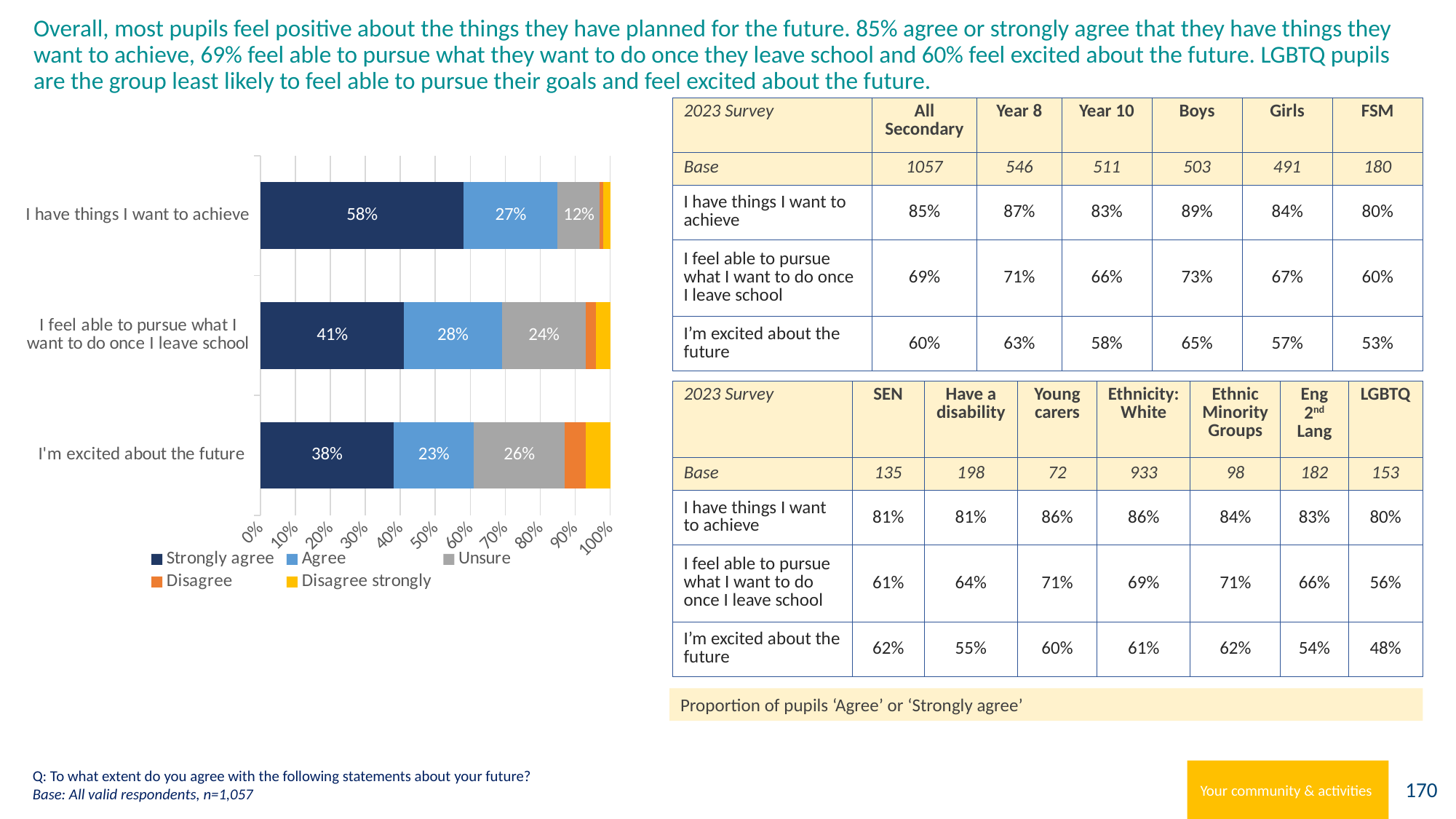
What is the difference between the 'Strongly agree' values for 'I have things I want to achieve' and 'I'm excited about the future'? 20% How many series does the chart legend list? 5 Which series in the legend is shown in grey? Unsure Which is larger: the 'Agree' value for 'I have things I want to achieve' or the 'Agree' value for 'I'm excited about the future'? I have things I want to achieve Is the 'Disagree strongly' value for 'I'm excited about the future' greater or less than 10%? less What is the 'Unsure' value for 'I'm excited about the future'? 26% Which statement has the highest 'Strongly agree' value? I have things I want to achieve What kind of chart is shown on the slide? bar chart Which statement has the lowest 'Unsure' value? I have things I want to achieve What is the 'Agree' value for 'I feel able to pursue what I want to do once I leave school'? 28% What is the 'Strongly agree' value for 'I have things I want to achieve'? 58% How many statements (categories) are plotted in the chart? 3